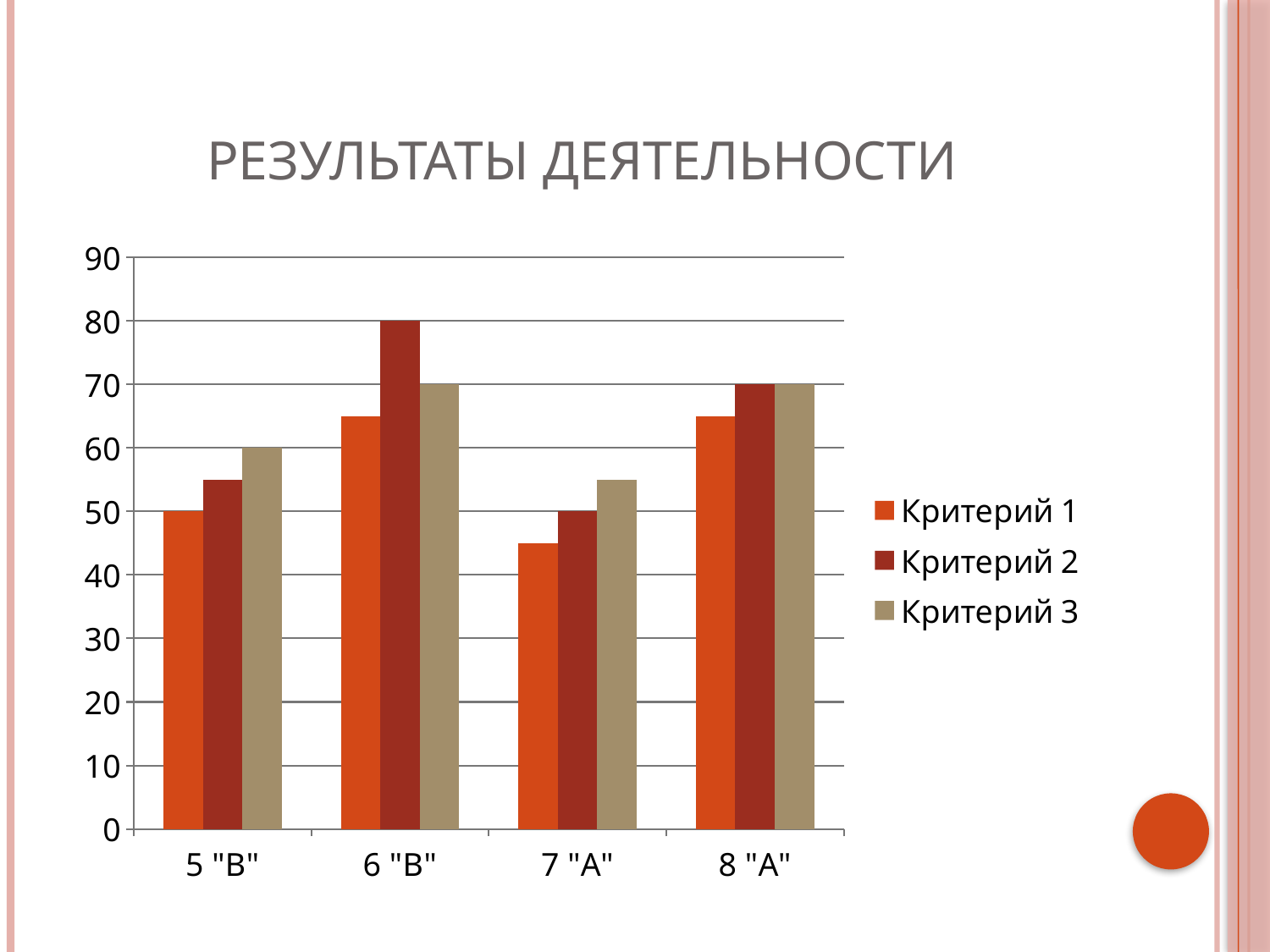
How many series does the legend list? 3 What is the difference between Критерий 2 and Критерий 3 for 6 "В"? 10 What is the value of Критерий 2 for 6 "В"? 80 What is the value of Критерий 1 for 5 "В"? 50 Which category has the highest bar for Критерий 2? 6 "В" How many categories are shown on the x axis? 4 Which is larger: Критерий 2 for 6 "В" or Критерий 2 for 8 "А"? 6 "В" Which category has the lowest bar for Критерий 1? 7 "А" What is the title of the chart? РЕЗУЛЬТАТЫ ДЕЯТЕЛЬНОСТИ What is the value of Критерий 3 for 5 "В"? 60 Is the value of Критерий 1 for 7 "А" greater or less than 50? less What kind of chart is shown on the slide? Bar chart